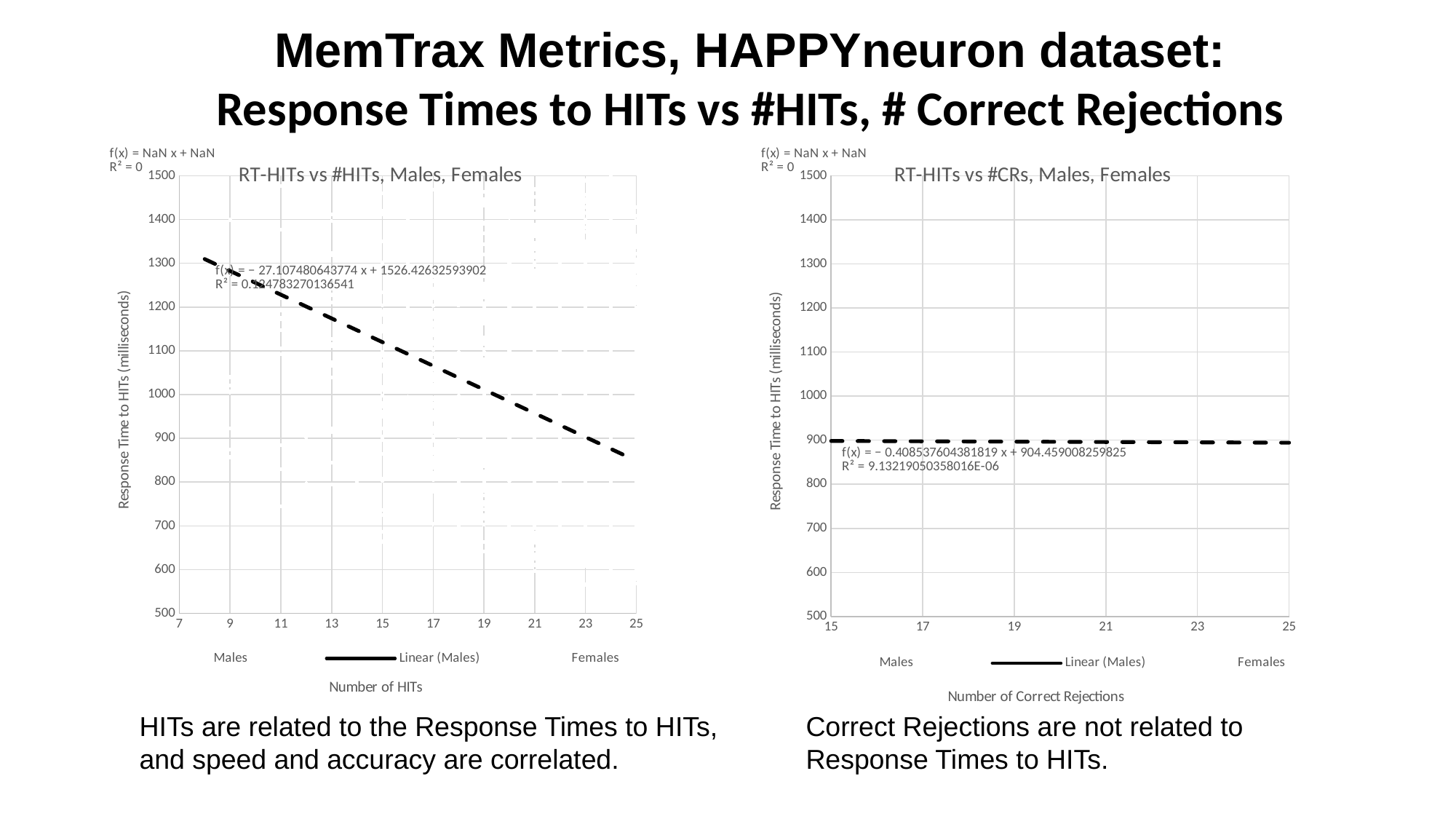
In the chart titled 'RT-HITs vs #CRs, Males, Females', does the dashed trend line rise, fall, or stay roughly flat as the number of correct rejections increases? roughly flat In the chart titled 'RT-HITs vs #HITs, Males, Females', what is the slope shown in the trend line equation? −27.107480643774 How many entries does the legend list in the chart titled 'RT-HITs vs #CRs, Males, Females'? 3 In the chart titled 'RT-HITs vs #HITs, Males, Females', is the trend line value at 9 HITs greater or less than 1200? greater In the chart titled 'RT-HITs vs #HITs, Males, Females', what kind of chart is shown? scatter chart How many entries does the legend list in the chart titled 'RT-HITs vs #HITs, Males, Females'? 3 In the chart titled 'RT-HITs vs #CRs, Males, Females', what is the intercept shown in the trend line equation? 904.459008259825 In the chart titled 'RT-HITs vs #CRs, Males, Females', is the trend line value at 25 correct rejections greater or less than 1000? less What is the x-axis label of the chart on the right of the slide? Number of Correct Rejections What is the y-axis label of the chart on the left of the slide? Response Time to HITs (milliseconds) In the chart titled 'RT-HITs vs #HITs, Males, Females', does the dashed trend line rise or fall as the number of HITs increases? fall In the chart titled 'RT-HITs vs #HITs, Males, Females', is the trend line value at 23 HITs greater or less than 1000? less